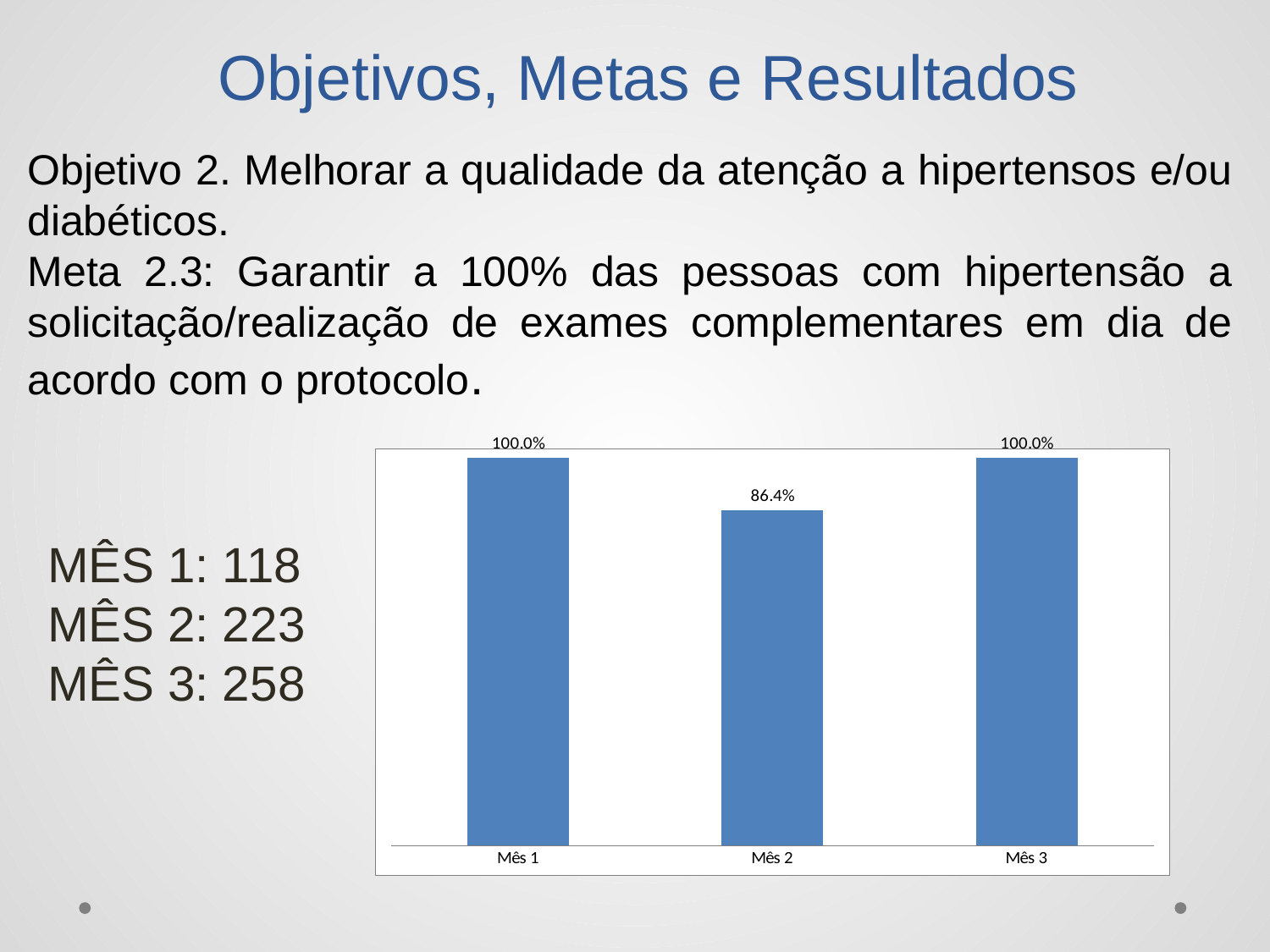
Do the values rise or fall from Mês 1 to Mês 2? Fall Are the values for Mês 1 and Mês 3 equal? Yes Which is larger, the value for Mês 2 or the value for Mês 3? Mês 3 Which month has the lowest value? Mês 2 What colour are the bars in the chart? Blue What is the difference between the values for Mês 1 and Mês 2? 13.6% What kind of chart is shown on the slide? Bar chart What is the value for Mês 2? 86.4% What is the value for Mês 3? 100.0% How many categories are shown on the x axis of the chart? 3 Do the values rise or fall from Mês 2 to Mês 3? Rise What is the value for Mês 1? 100.0%